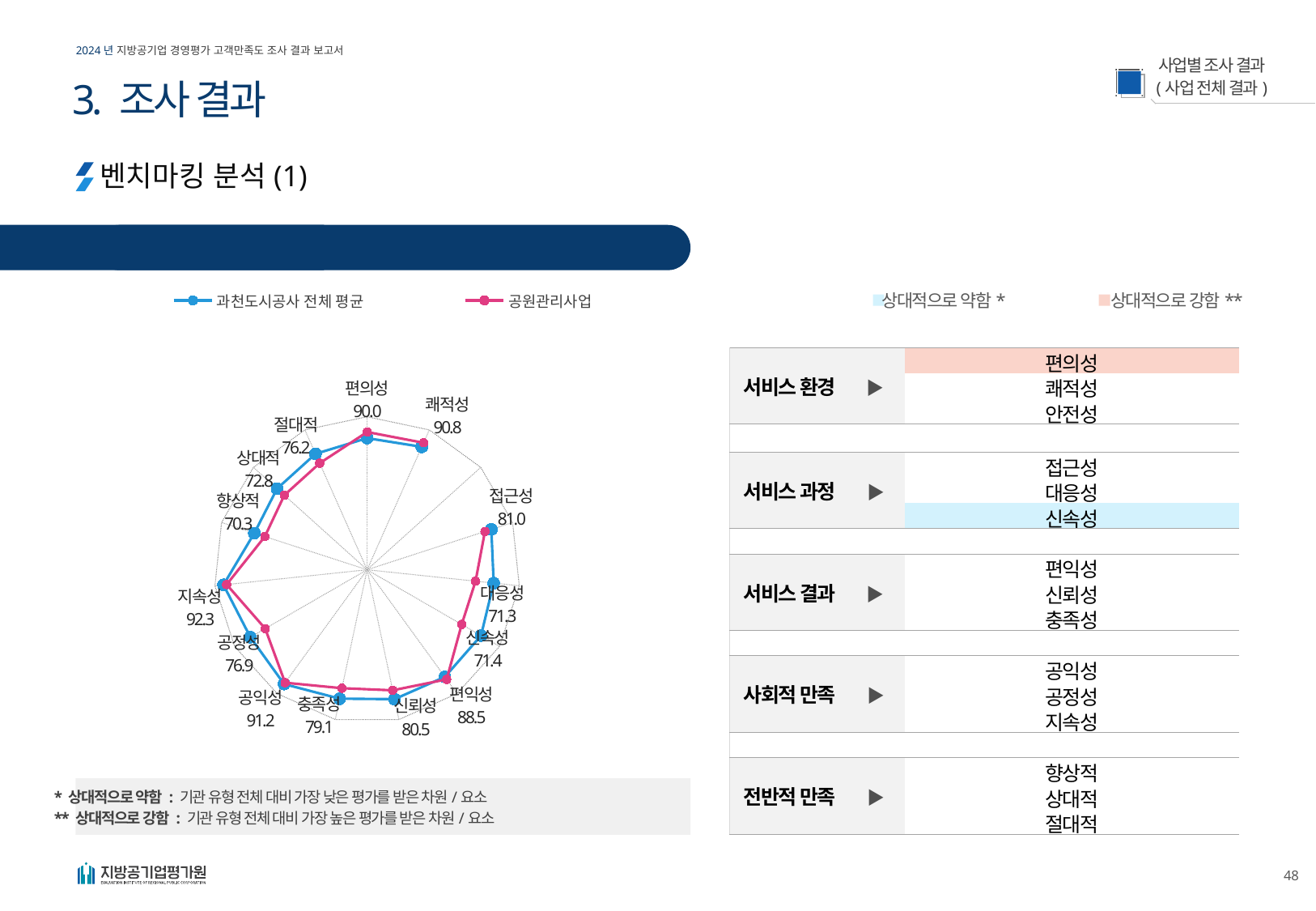
How many series does the chart legend list? 2 What value is labelled for 신속성 on the radar chart? 71.4 Which category has the lowest labelled value on the radar chart? 향상적 What is the difference between the labelled values for 지속성 and 향상적? 22.0 What are the two series named in the chart legend? 과천도시공사 전체 평균 and 공원관리사업 What value is labelled for 공익성 on the radar chart? 91.2 What kind of chart is shown on the slide? radar chart Which has the larger labelled value, 쾌적성 or 편의성? 쾌적성 What value is labelled for 편의성 on the radar chart? 90.0 What value is labelled for 지속성 on the radar chart? 92.3 Which category has the highest labelled value on the radar chart? 지속성